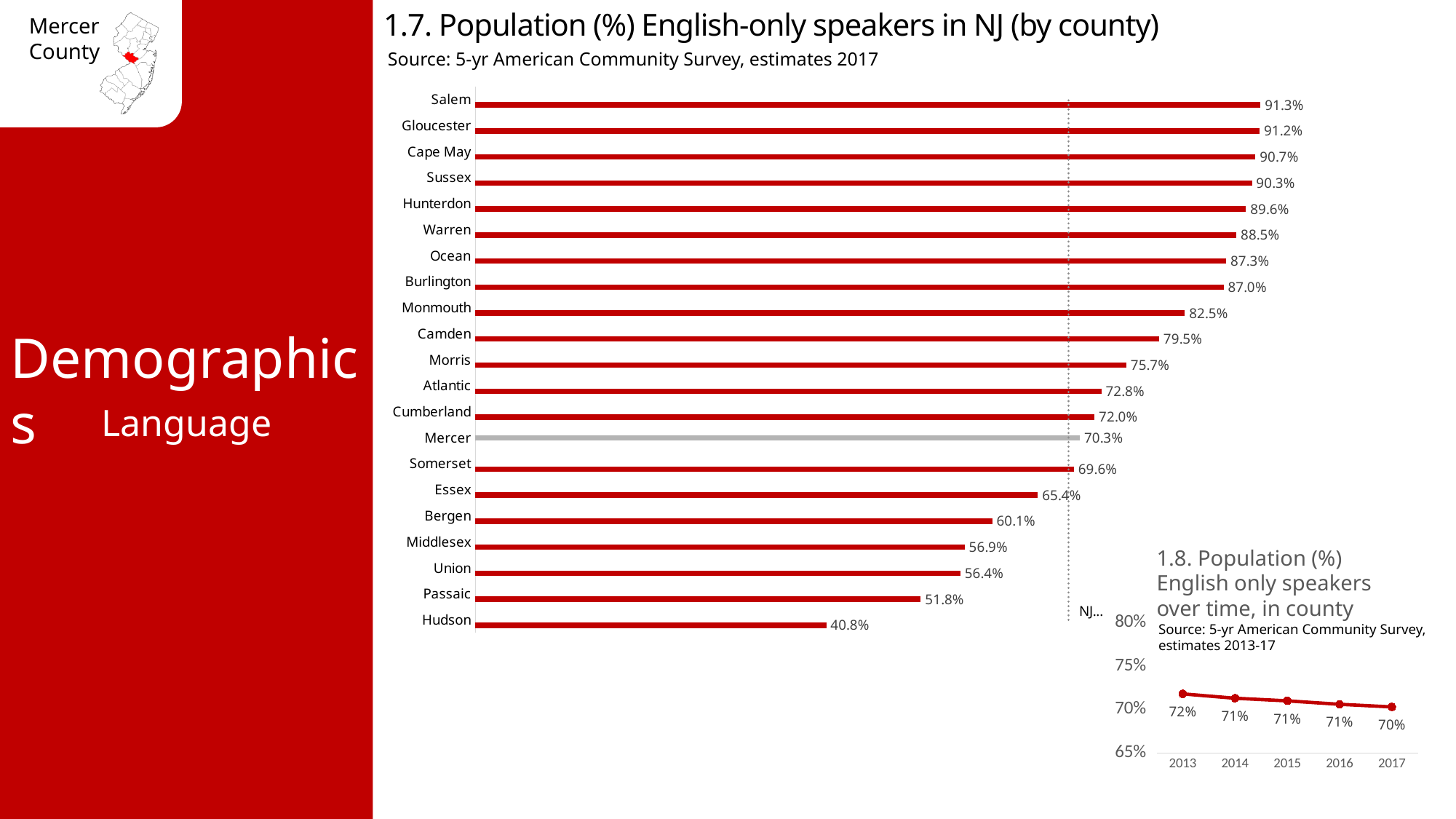
In chart 1.7 (English-only speakers by county), which county's bar is coloured grey instead of red? Mercer In chart 1.7 (English-only speakers by county), what is the value for Mercer? 70.3% In chart 1.7 (English-only speakers by county), which is larger, the value for Bergen or the value for Essex? Essex In chart 1.7 (English-only speakers by county), which county has the lowest value? Hudson In chart 1.7 (English-only speakers by county), what is the difference between Salem and Hudson? 50.5% In chart 1.8 (English only speakers over time), do the values rise or fall from 2013 to 2017? Fall In chart 1.7 (English-only speakers by county), how many counties are shown? 21 In chart 1.8 (English only speakers over time), what is the value for 2013? 72% In chart 1.8 (English only speakers over time), how many years are plotted? 5 In chart 1.7 (English-only speakers by county), what is the value for Hudson? 40.8% What kind of chart is chart 1.7 (English-only speakers by county)? Bar chart In chart 1.7 (English-only speakers by county), which county has the highest value? Salem